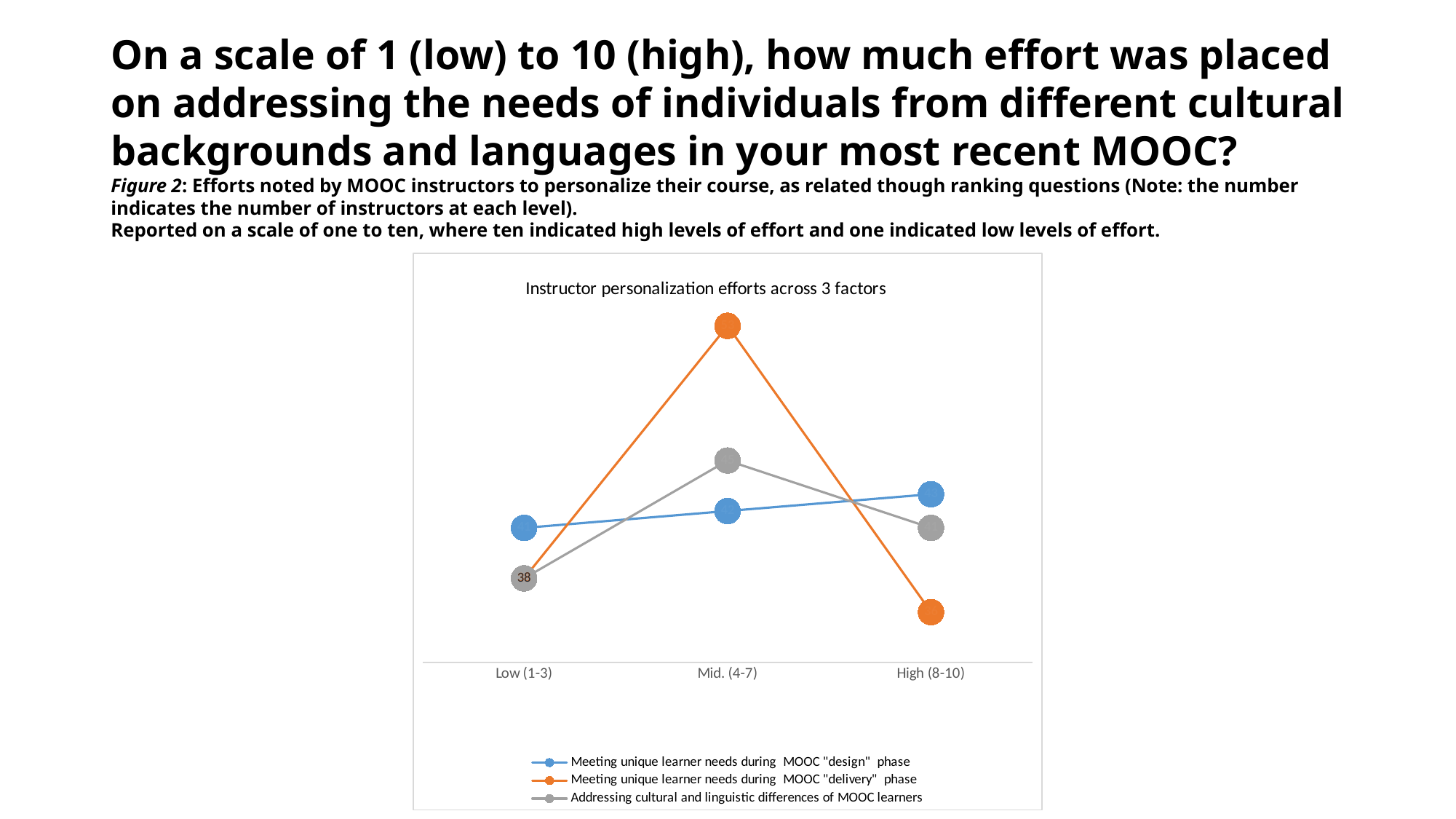
What value is labelled for 'Addressing cultural and linguistic differences of MOOC learners' at Low (1-3)? 38 At High (8-10), which series is higher: the "design" phase series or the 'Addressing cultural and linguistic differences of MOOC learners' series? Meeting unique learner needs during MOOC "design" phase At which category does the 'Meeting unique learner needs during MOOC "delivery" phase' series reach its lowest point? High (8-10) What kind of chart is shown on the slide? line chart How many series does the legend list? 3 At which category does the 'Addressing cultural and linguistic differences of MOOC learners' series reach its highest point? Mid. (4-7) At which category does the 'Meeting unique learner needs during MOOC "delivery" phase' series reach its highest point? Mid. (4-7) At which category does the 'Meeting unique learner needs during MOOC "design" phase' series reach its highest point? High (8-10) Does the 'Meeting unique learner needs during MOOC "design" phase' series rise or fall from Low (1-3) to High (8-10)? rise At Mid. (4-7), which series is higher: the "design" phase series or the "delivery" phase series? Meeting unique learner needs during MOOC "delivery" phase How many categories are shown on the x axis? 3 What is the title of the chart? Instructor personalization efforts across 3 factors